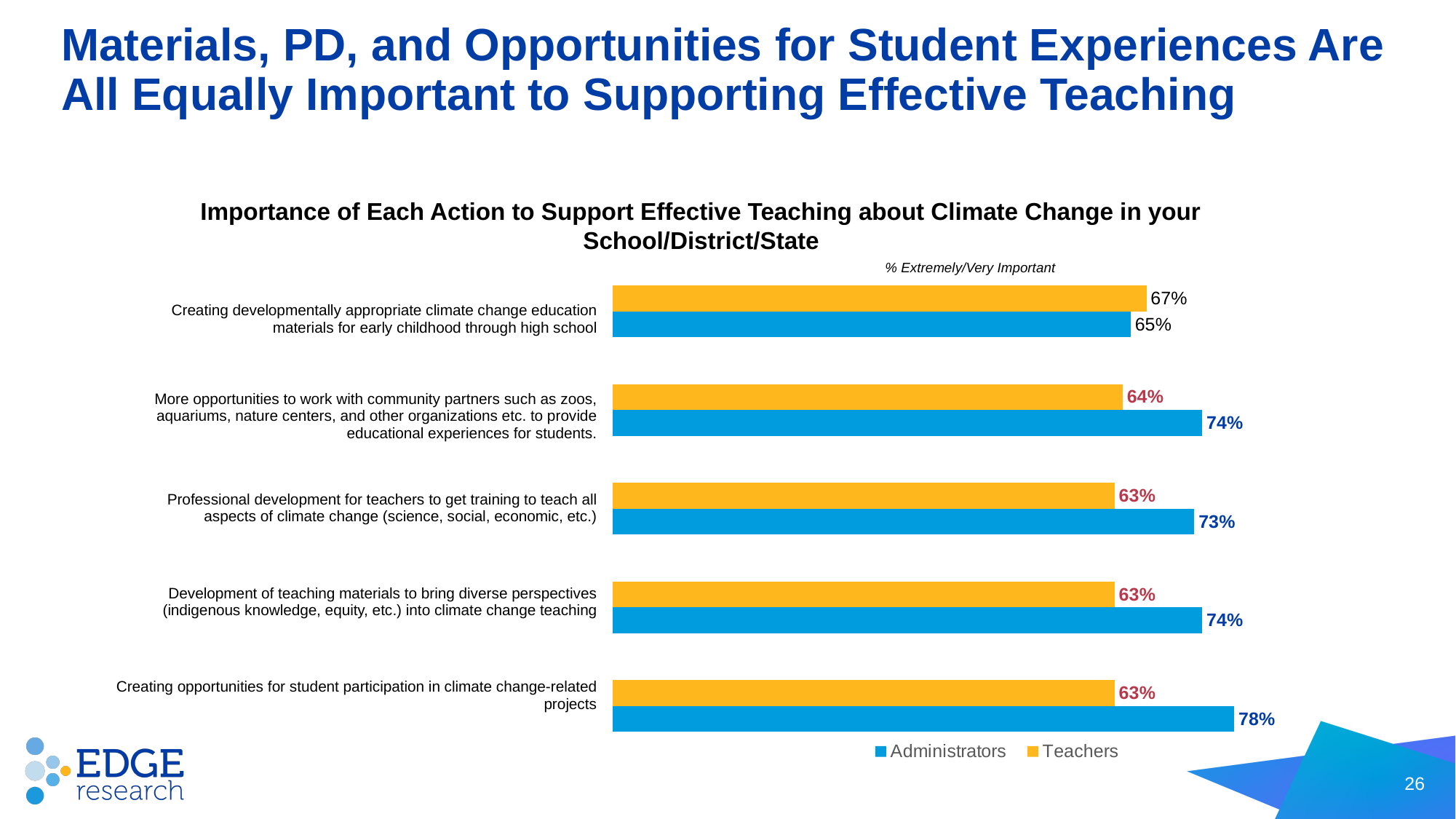
For creating developmentally appropriate climate change education materials, which group has the higher value, Administrators or Teachers? Teachers What percentage of Administrators rated creating opportunities for student participation in climate change-related projects as extremely/very important? 78% Which action has the highest Teachers value? Creating developmentally appropriate climate change education materials for early childhood through high school What is the Administrators value for professional development for teachers to get training to teach all aspects of climate change? 73% How many series does the legend list? 2 How many actions are shown in the chart? 5 Which action has the lowest Administrators value? Creating developmentally appropriate climate change education materials for early childhood through high school What type of chart is shown on the slide? Bar chart What is the Teachers value for more opportunities to work with community partners such as zoos, aquariums, nature centers, and other organizations? 64% What is the difference between the Administrators and Teachers values for creating opportunities for student participation in climate change-related projects? 15 percentage points What percentage of Teachers rated creating developmentally appropriate climate change education materials for early childhood through high school as extremely/very important? 67% Which action has the highest Administrators value? Creating opportunities for student participation in climate change-related projects